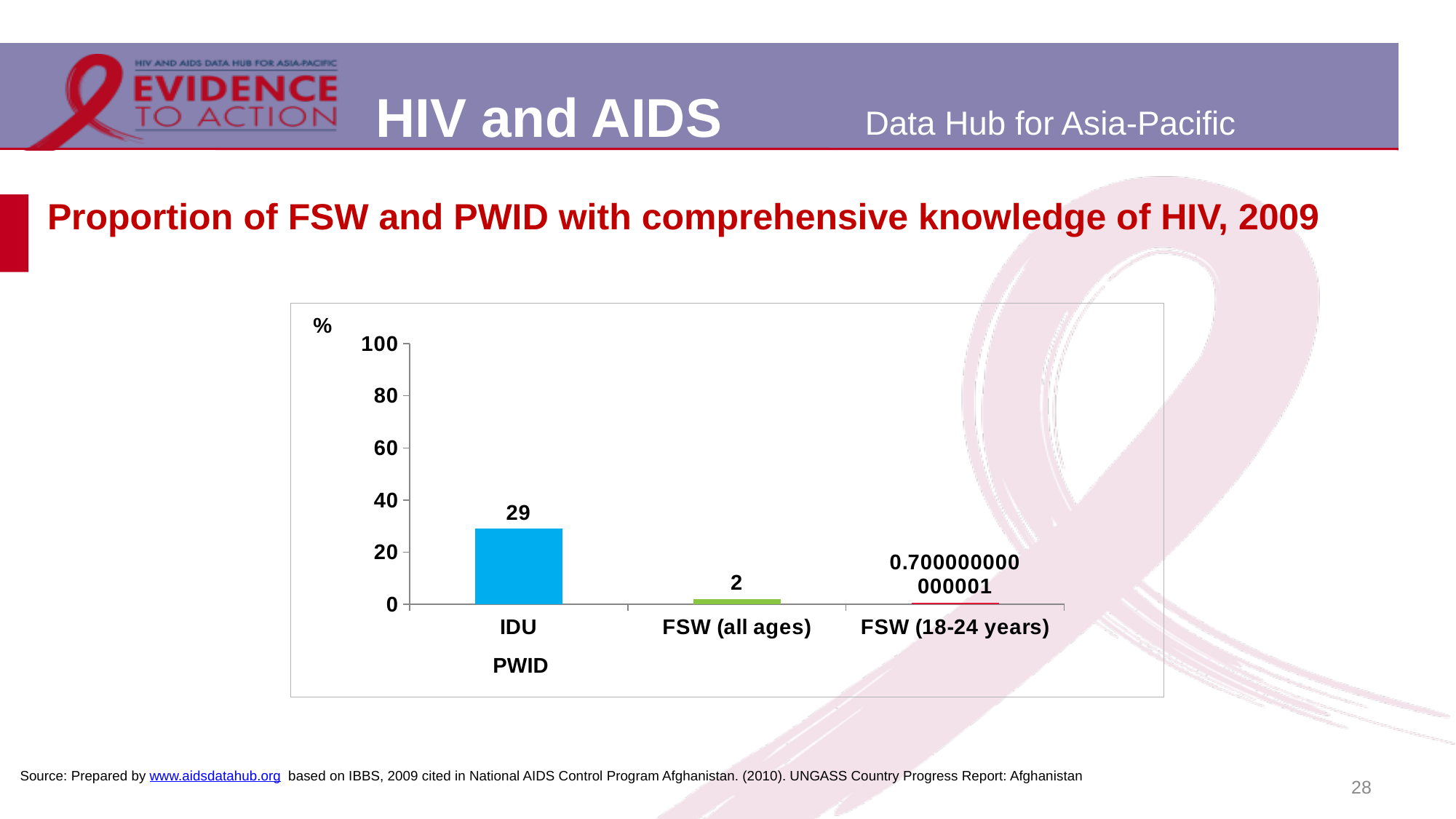
Is the value for IDU greater or less than 40? less What unit is shown on the y axis? % Which category has the highest value? IDU What is the difference between the values for IDU and FSW (all ages)? 27 Which category has the lowest value? FSW (18-24 years) How many categories are shown on the x axis? 3 Which is larger, the value for IDU or the value for FSW (all ages)? IDU What is the title of the chart? Proportion of FSW and PWID with comprehensive knowledge of HIV, 2009 What is the value for FSW (all ages)? 2 What is the value for IDU (PWID)? 29 What kind of chart is shown on the slide? bar chart Is the value for IDU greater or less than 20? greater